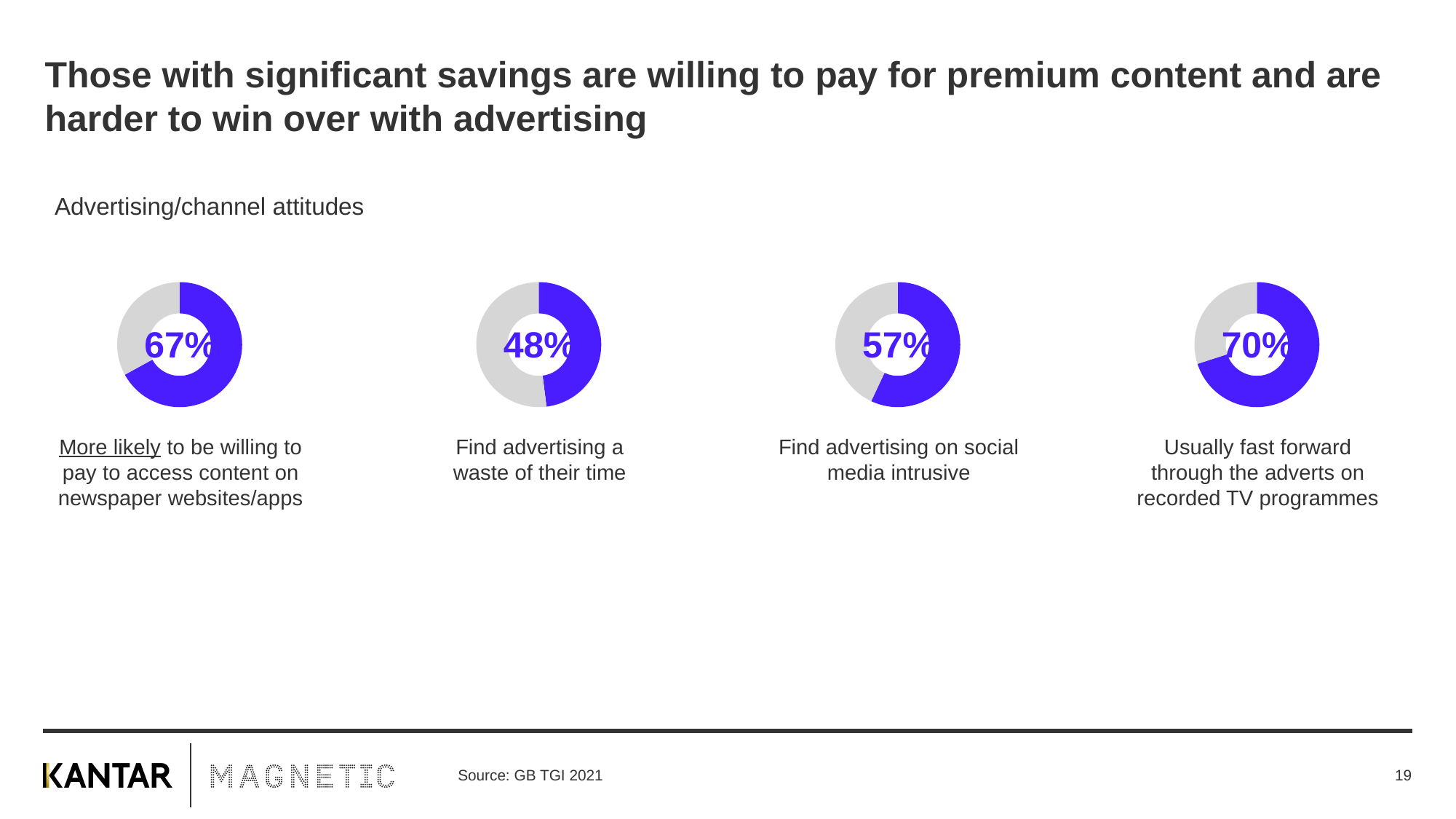
Which of the four donut charts shows the lowest percentage? Find advertising a waste of their time How many donut charts are shown on the slide? 4 What is the difference between the percentage for the leftmost donut chart (67%) and the percentage for 'Find advertising on social media intrusive'? 10% Which of the four donut charts shows the highest percentage? Usually fast forward through the adverts on recorded TV programmes What percentage is shown in the donut chart labelled 'Find advertising on social media intrusive'? 57% What kind of chart is used to display each percentage on the slide? Donut chart What percentage is shown in the donut chart labelled 'Find advertising a waste of their time'? 48% Which is larger: the percentage for 'Find advertising on social media intrusive' or the percentage for 'Find advertising a waste of their time'? Find advertising on social media intrusive What is the difference between the percentage for 'Usually fast forward through the adverts on recorded TV programmes' and the percentage for 'Find advertising a waste of their time'? 22% What percentage is shown in the leftmost donut chart, about being more likely to be willing to pay to access content on newspaper websites/apps? 67% What is the heading above the four donut charts? Advertising/channel attitudes What percentage is shown in the donut chart labelled 'Usually fast forward through the adverts on recorded TV programmes'? 70%